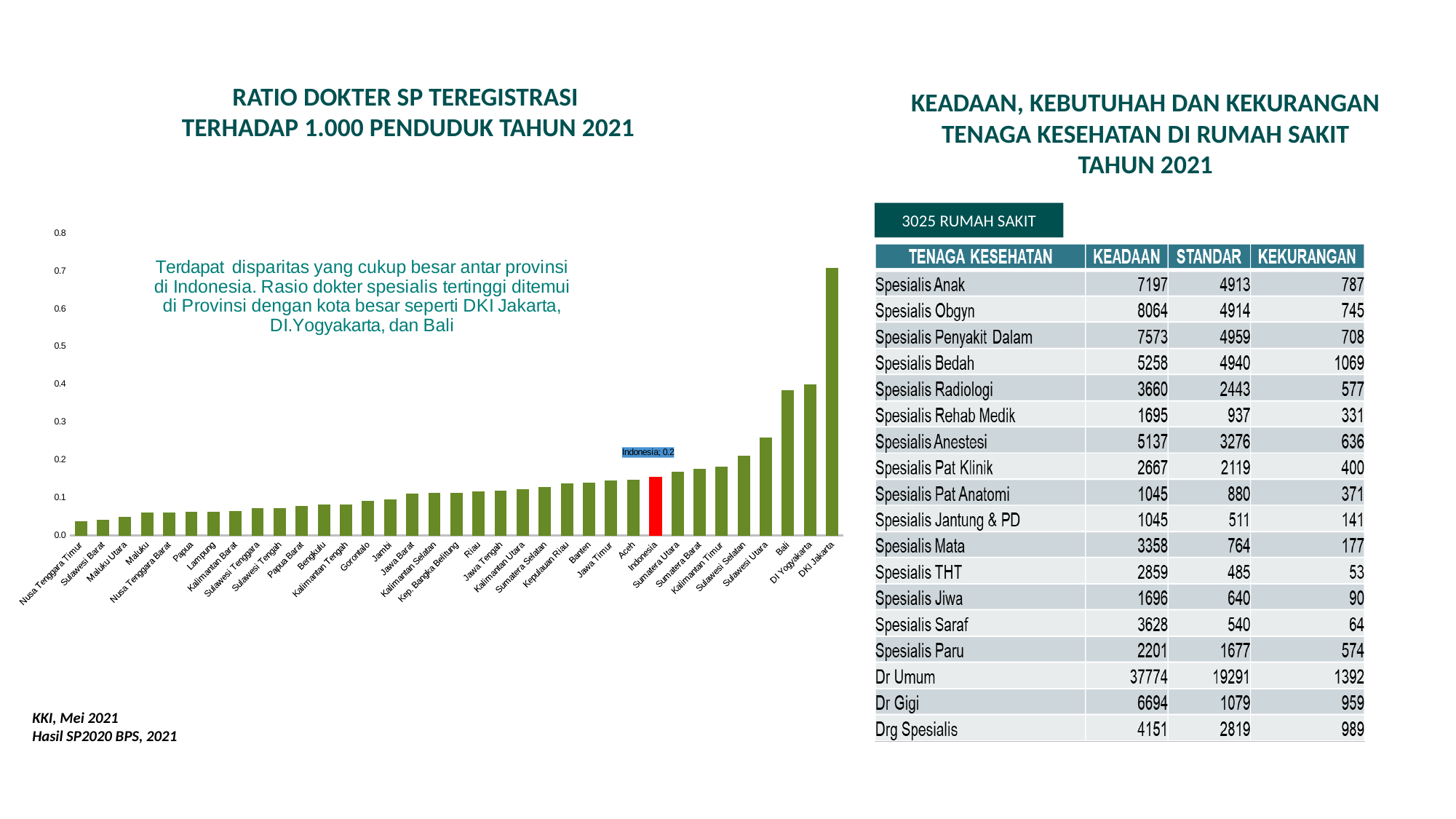
How many bars are plotted in the bar chart? 35 Is the value for Bali greater or less than 0.3? greater Do the bar values rise or fall from left to right along the x axis? rise What is the value labelled for Indonesia in the bar chart? 0.2 Is the value for Sulawesi Utara greater or less than 0.2? greater Which bar in the chart is coloured red? Indonesia Is the value for DKI Jakarta greater or less than 0.6? greater What kind of chart is shown on the left of the slide? bar chart Which has the larger value in the bar chart, DKI Jakarta or Bali? DKI Jakarta Which province has the highest ratio in the bar chart? DKI Jakarta